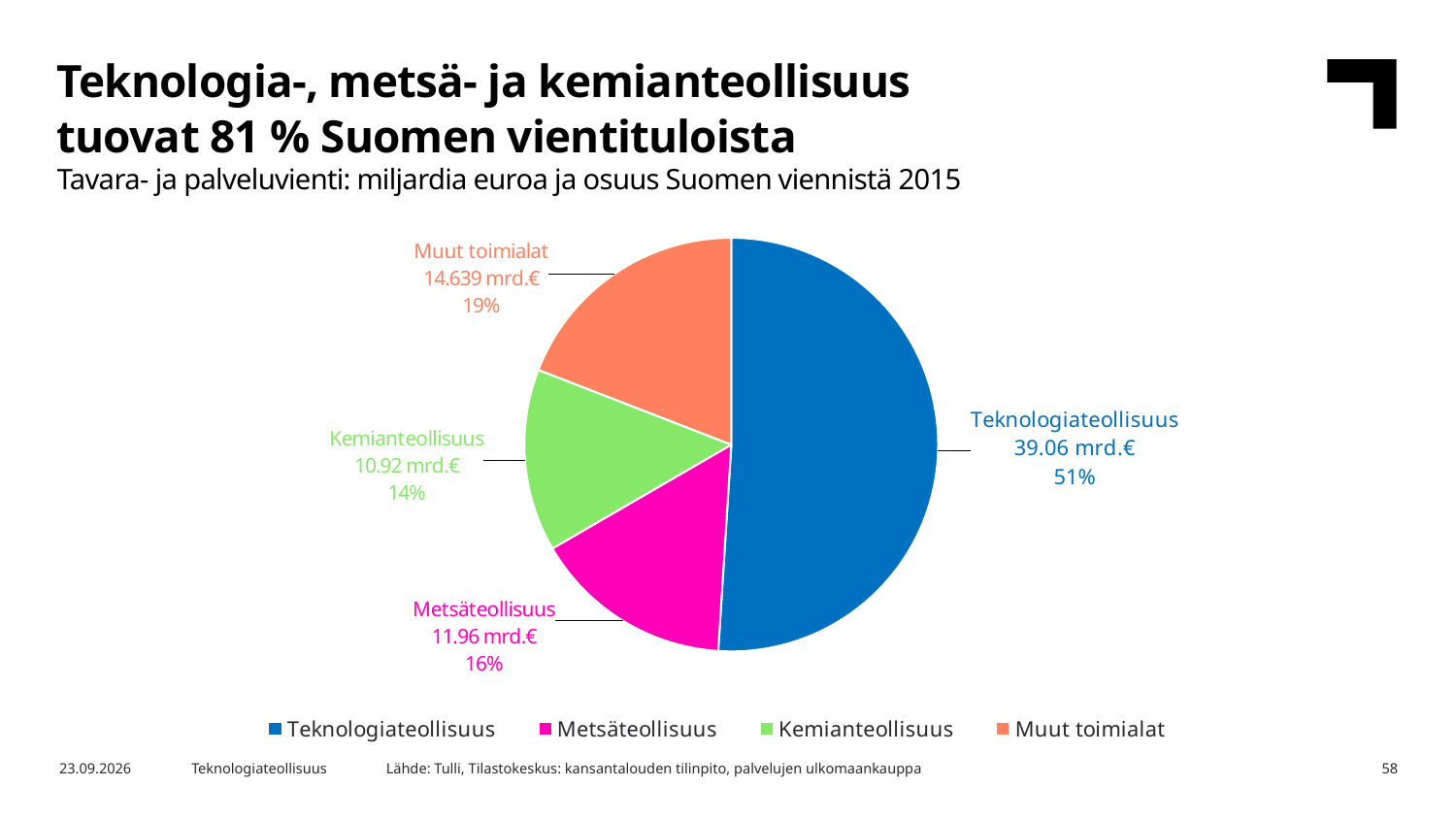
What colour is the Kemianteollisuus slice? Green What is the export value shown for Teknologiateollisuus? 39.06 mrd.€ What share of Finland's exports does Metsäteollisuus account for? 16% Which sector has the smallest slice of the pie? Kemianteollisuus Which is larger, the export value of Metsäteollisuus or Muut toimialat? Muut toimialat What kind of chart is shown on the slide? Pie chart What is the difference in export value between Teknologiateollisuus and Metsäteollisuus? 27.10 mrd.€ How many slices does the pie chart have? 4 Which sector has the largest slice of the pie? Teknologiateollisuus What is the export value shown for Kemianteollisuus? 10.92 mrd.€ What share of the pie does Muut toimialat represent? 19% How many entries does the legend list? 4